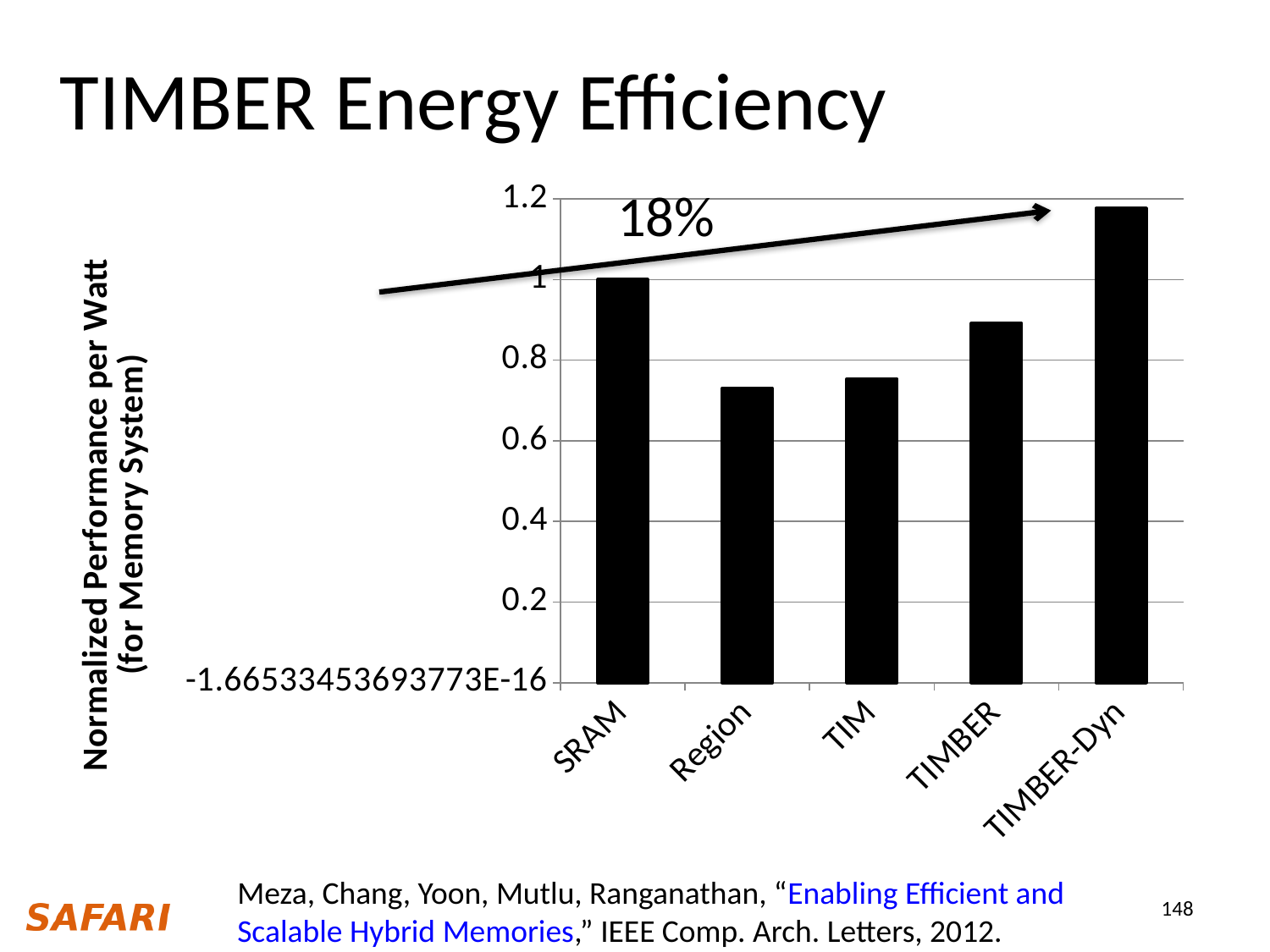
Which is larger, the value for SRAM or the value for TIMBER? SRAM What is the normalized performance per watt for SRAM? 1 What percentage is written next to the arrow annotation on the chart? 18% Is the value for TIM greater or less than 0.8? less Is the value for TIMBER greater or less than 1? less How many categories are plotted on the x axis of the chart? 5 Is the value for TIMBER greater or less than 0.8? greater What kind of chart is shown on the slide? bar chart Which category has the highest normalized performance per watt? TIMBER-Dyn Which is larger, the value for TIMBER or the value for Region? TIMBER